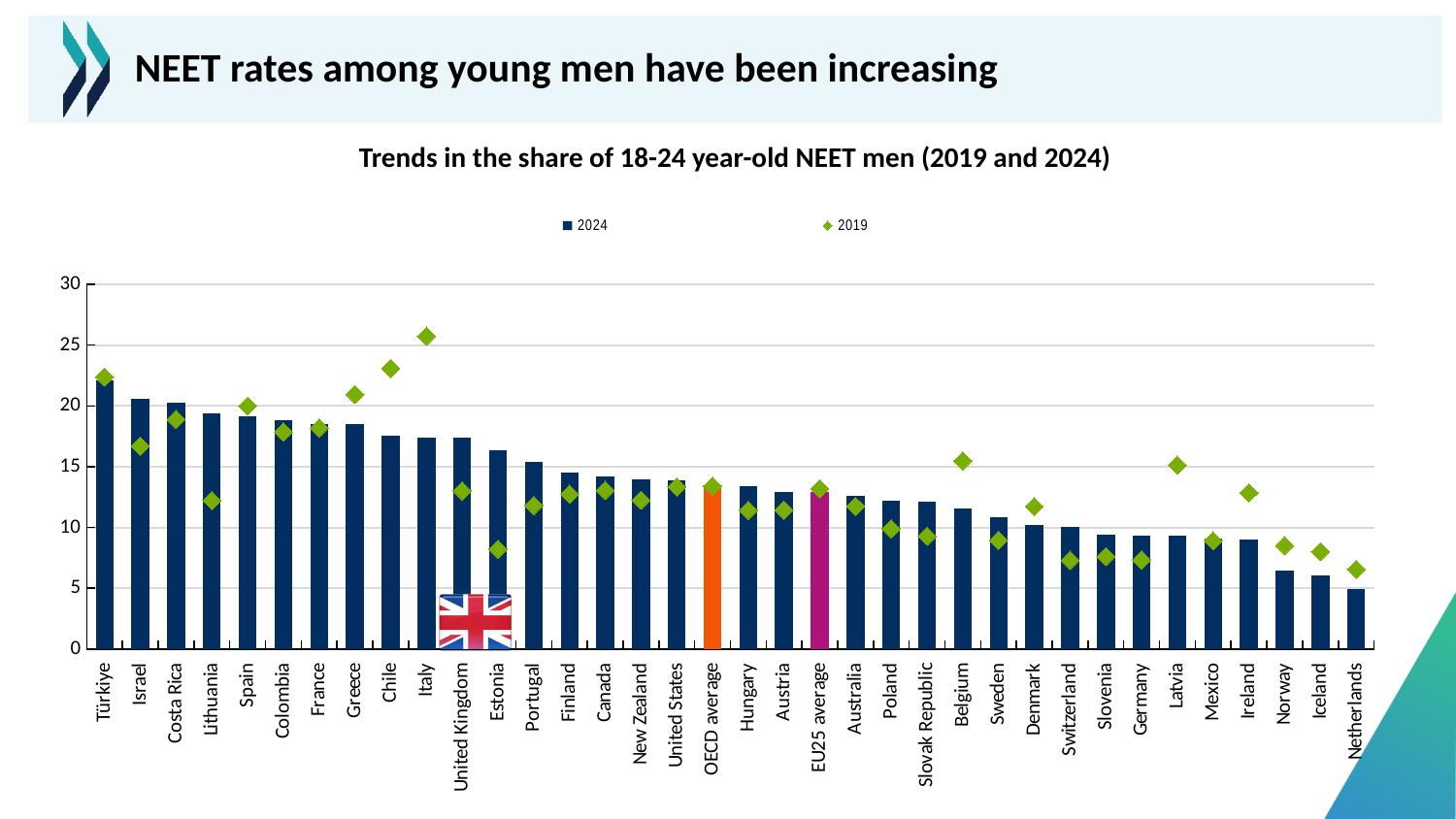
Is the 2024 value for Norway greater or less than 10? less Which country has the lowest 2024 bar? Netherlands Which has the larger 2024 value: Israel or Norway? Israel How many series does the legend list? 2 Do the 2024 bars generally rise or fall from left to right along the x axis? fall Which country has the highest 2019 marker? Italy What kind of chart is shown on the slide? bar chart Is the 2019 value for Estonia greater or less than 10? less Which country has the highest 2024 bar? Türkiye Is the 2024 value for Türkiye greater or less than 20? greater For Italy, which is larger: the 2019 value or the 2024 value? 2019